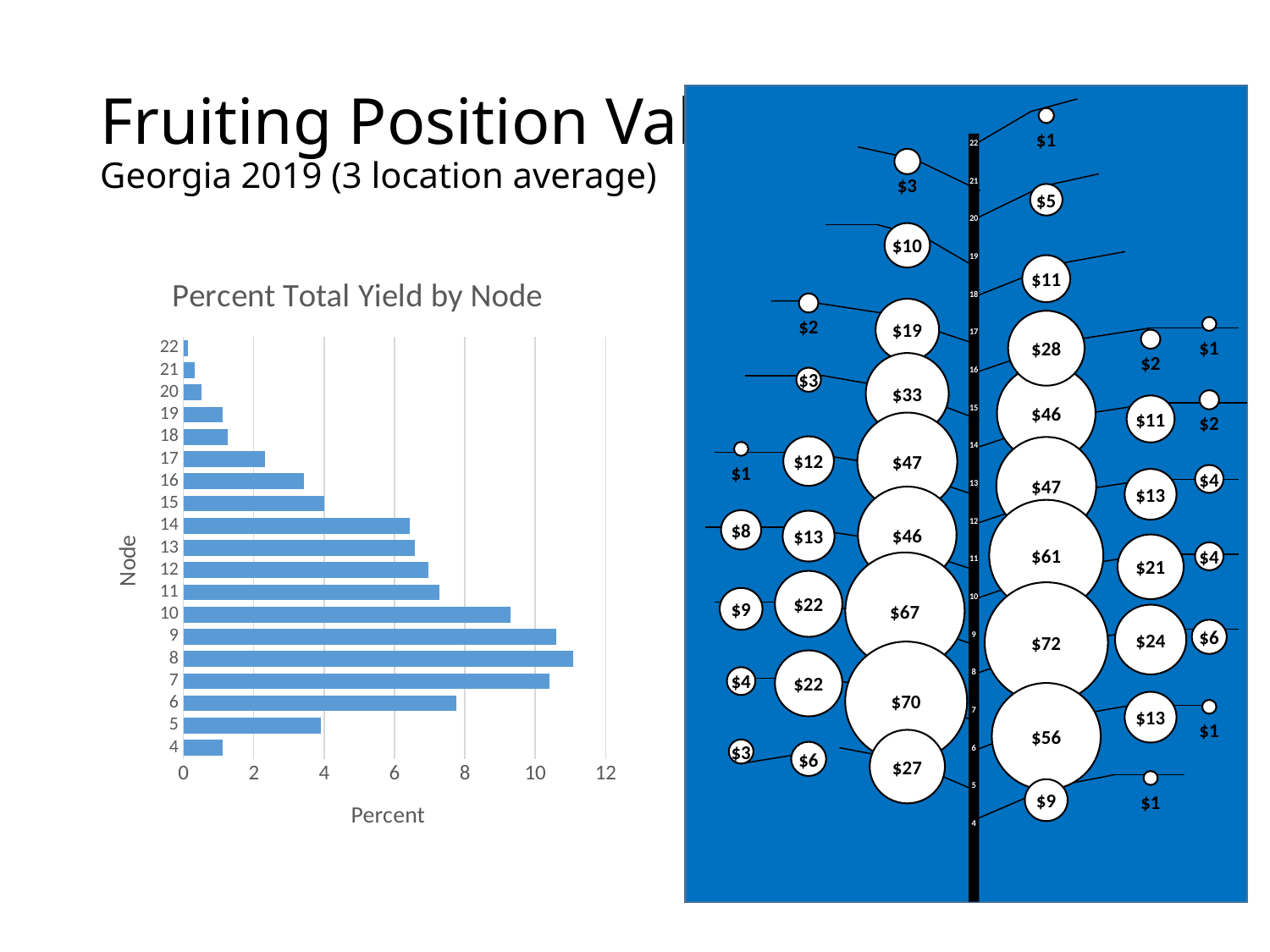
How many nodes are shown in the "Percent Total Yield by Node" chart? 19 In the "Percent Total Yield by Node" chart, is the value for node 6 greater or less than 8? less In the "Percent Total Yield by Node" chart, do the values rise or fall going from node 8 up to node 22? fall What is the label on the horizontal axis of the "Percent Total Yield by Node" chart? Percent In the "Percent Total Yield by Node" chart, which has a larger value: node 14 or node 15? node 14 In the "Percent Total Yield by Node" chart, which has a larger value: node 10 or node 6? node 10 In the "Percent Total Yield by Node" chart, is the value for node 10 greater or less than 8? greater In the "Percent Total Yield by Node" chart, is the value for node 16 greater or less than 4? less In the "Percent Total Yield by Node" chart, which node has the highest percent of total yield? 8 What type of chart is "Percent Total Yield by Node"? bar chart In the "Percent Total Yield by Node" chart, which node has the lowest percent of total yield? 22